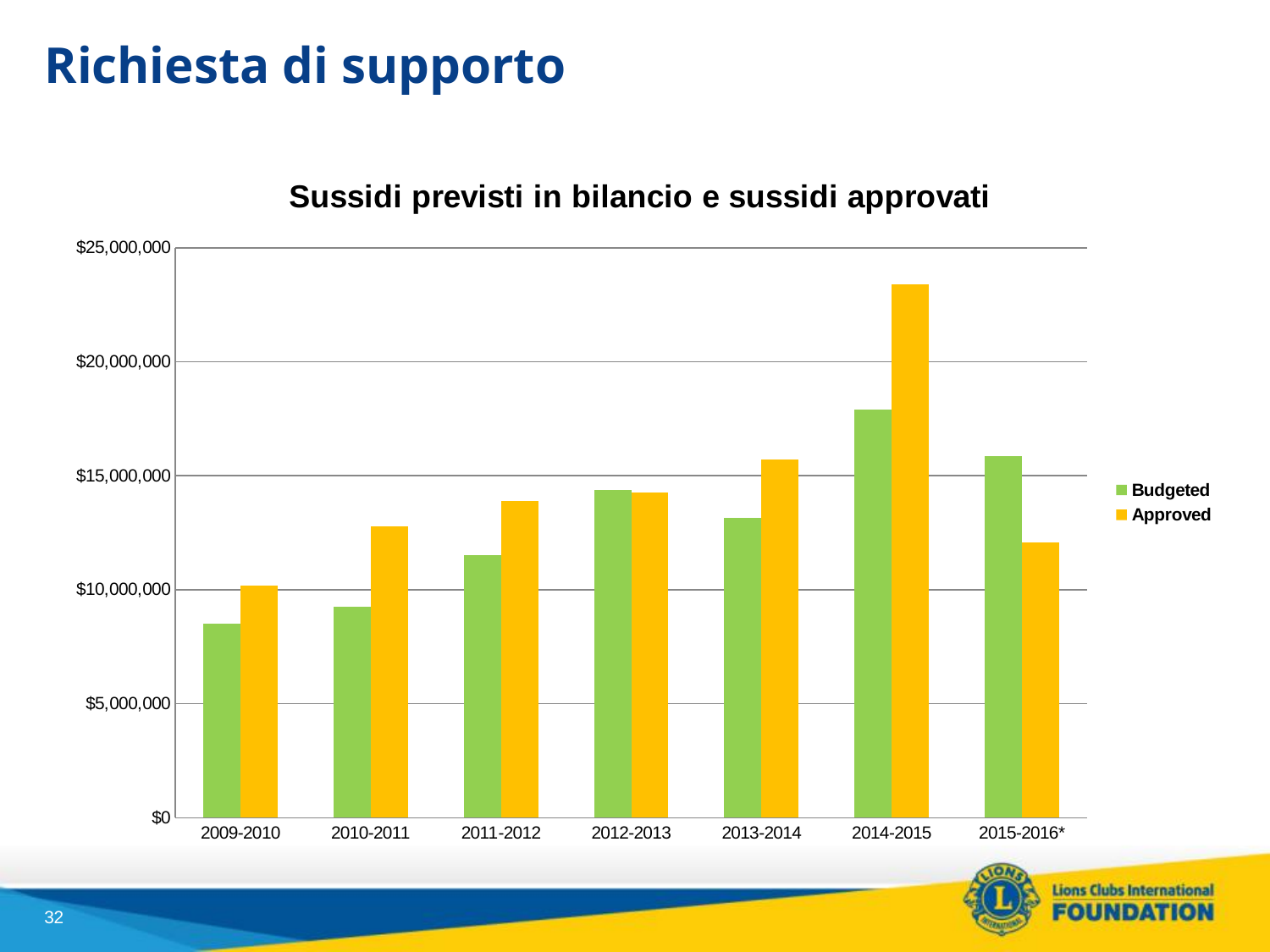
What is the title of the chart? Sussidi previsti in bilancio e sussidi approvati For 2015-2016*, which is larger, Budgeted or Approved? Budgeted How many fiscal-year categories are shown on the x axis? 7 In which year is the Budgeted value lowest? 2009-2010 How many series does the legend list? 2 Is the Approved value for 2014-2015 greater or less than $20,000,000? greater For 2010-2011, which is larger, Budgeted or Approved? Approved In which year is the Budgeted value highest? 2014-2015 In which year is the Approved value lowest? 2009-2010 Is the Budgeted value for 2009-2010 greater or less than $10,000,000? less What kind of chart is shown on the slide? Bar chart In which year is the Approved value highest? 2014-2015